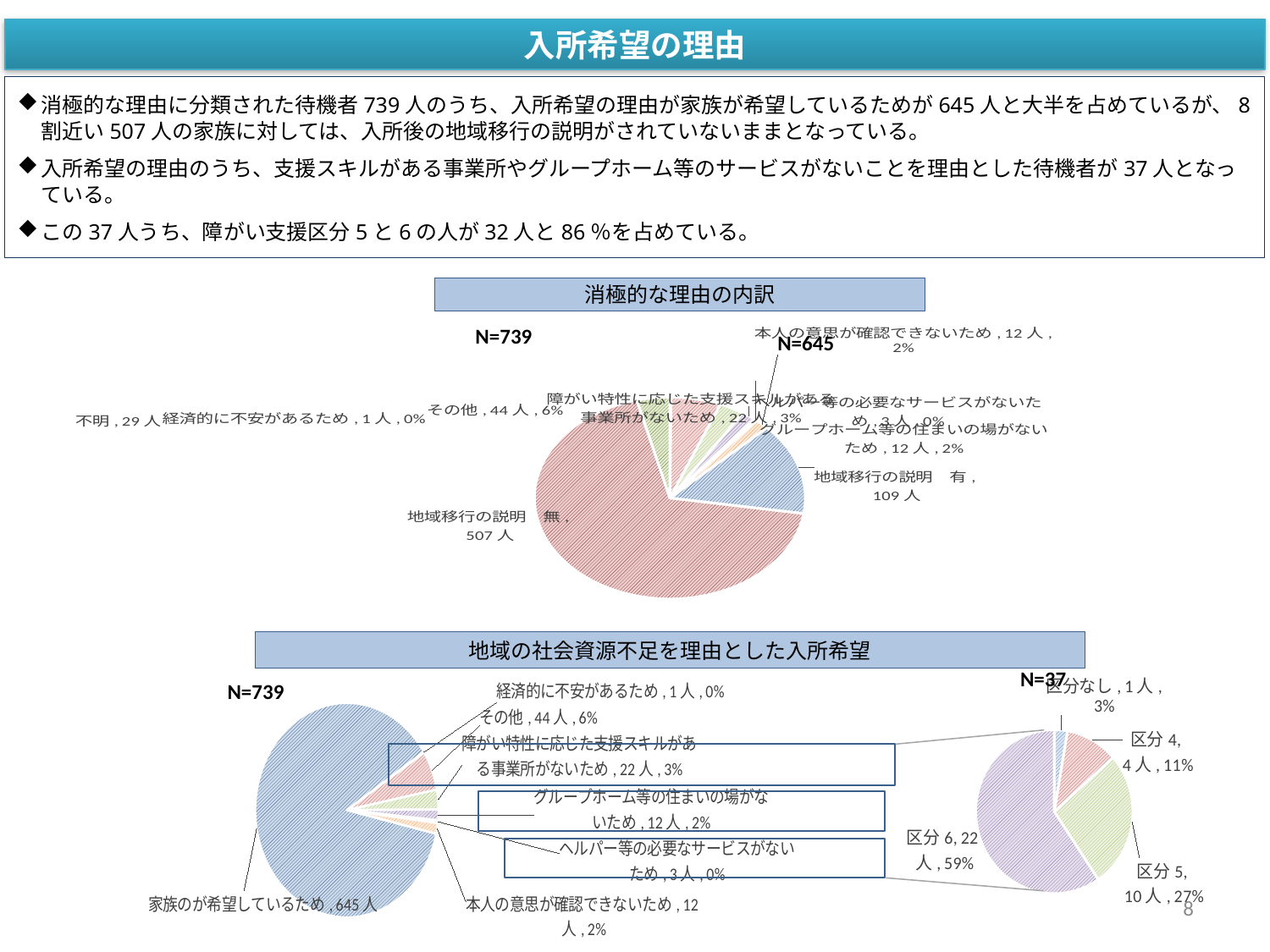
In the top chart 消極的な理由の内訳, how many people are in the 地域移行の説明 有 slice? 109人 In the bottom-right chart (N=37), which category has the smallest slice? 区分なし In the bottom-right chart (N=37), how many people are in 区分6? 22人 In the bottom-left chart (N=739), which is larger: その他 or 障がい特性に応じた支援スキルがある事業所がないため? その他 In the top chart 消極的な理由の内訳, how many people are in the 地域移行の説明 無 slice? 507人 What kind of chart is used in the bottom-right chart (N=37) on the slide? pie chart In the bottom-right chart (N=37), which category has the largest slice? 区分6 In the bottom-right chart (N=37), what share of the pie does 区分5 represent? 27% In the bottom-right chart (N=37), how many categories are shown? 4 In the bottom-left chart (N=739), how many people are in the 家族のが希望しているため slice? 645人 In the bottom-left chart (N=739), what percentage is shown for グループホーム等の住まいの場がないため? 2% In the bottom-right chart (N=37), what is the difference in number of people between 区分6 and 区分5? 12人